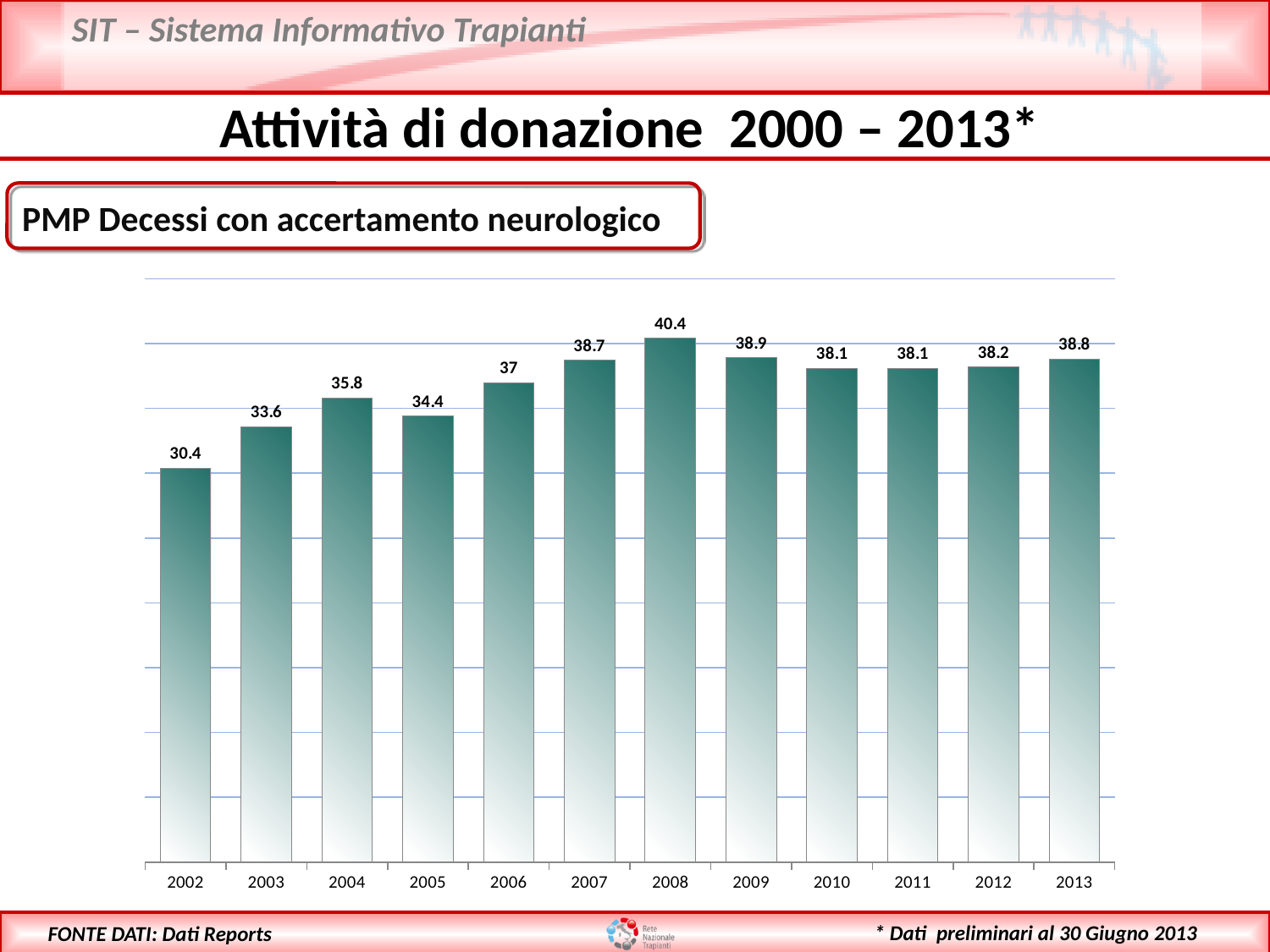
Which year has the highest value? 2008 What is the value for 2008? 40.4 What kind of chart is shown on the slide? bar chart Which is larger, the value for 2005 or the value for 2006? 2006 What is the difference between the values for 2008 and 2002? 10 Which year has the lowest value? 2002 How many years are shown on the x axis? 12 What is the difference between the values for 2004 and 2003? 2.2 Do the values rise or fall from 2002 to 2008? rise What is the label in the box above the chart? PMP Decessi con accertamento neurologico What is the value for 2002? 30.4 What is the value for 2013? 38.8